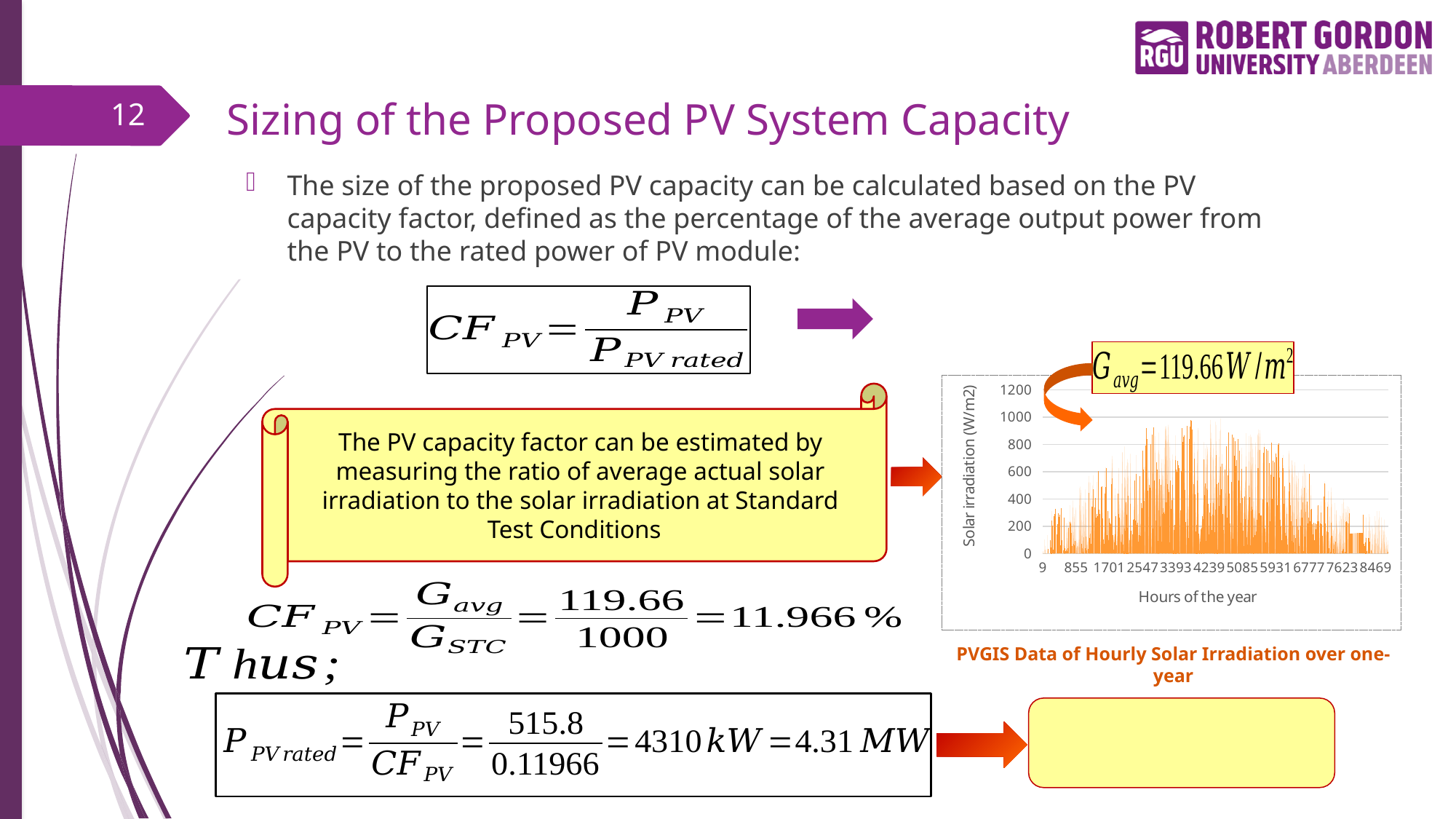
What kind of chart is shown on the slide? bar chart What is the label of the horizontal axis of the chart? Hours of the year Is the peak solar irradiation value in the chart greater or less than 800? greater What is the label of the vertical axis of the chart? Solar irradiation (W/m2) What average solar irradiation value (G_avg) is annotated on the chart? 119.66 W/m2 What is the highest tick value shown on the vertical axis of the chart? 1200 What is the last tick value shown on the horizontal axis of the chart? 8469 What is the first tick value shown on the horizontal axis of the chart? 9 Do the solar irradiation values in the chart generally rise then fall across the hours of the year, or fall then rise? rise then fall How many tick labels are shown along the horizontal axis of the chart? 11 Is the peak solar irradiation value in the chart greater or less than 1200? less